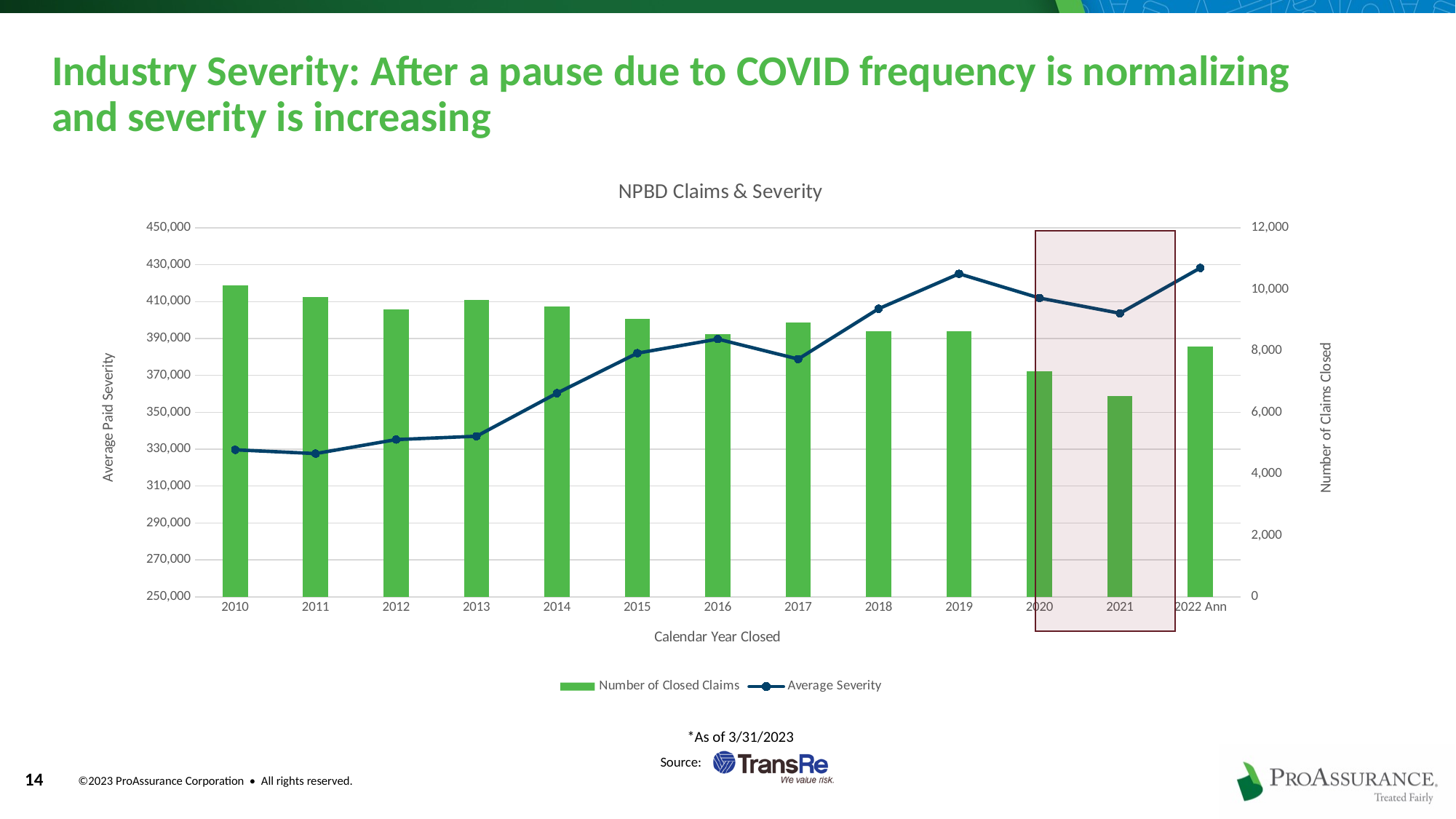
How many calendar years are shown on the x axis? 13 Which is larger, the Average Severity for 2014 or for 2019? 2019 What is the title of the chart? NPBD Claims & Severity How many series does the chart legend list? 2 Which year has the highest Number of Closed Claims? 2010 Is the Number of Closed Claims for 2021 greater or less than 8,000? less What kind of chart is shown on the slide? Combined bar and line chart Is the Average Severity for 2019 greater or less than 410,000? greater Is the Number of Closed Claims for 2010 greater or less than 8,000? greater Does the Average Severity line generally rise or fall from 2010 to 2019? rise Which year has the lowest Number of Closed Claims? 2021